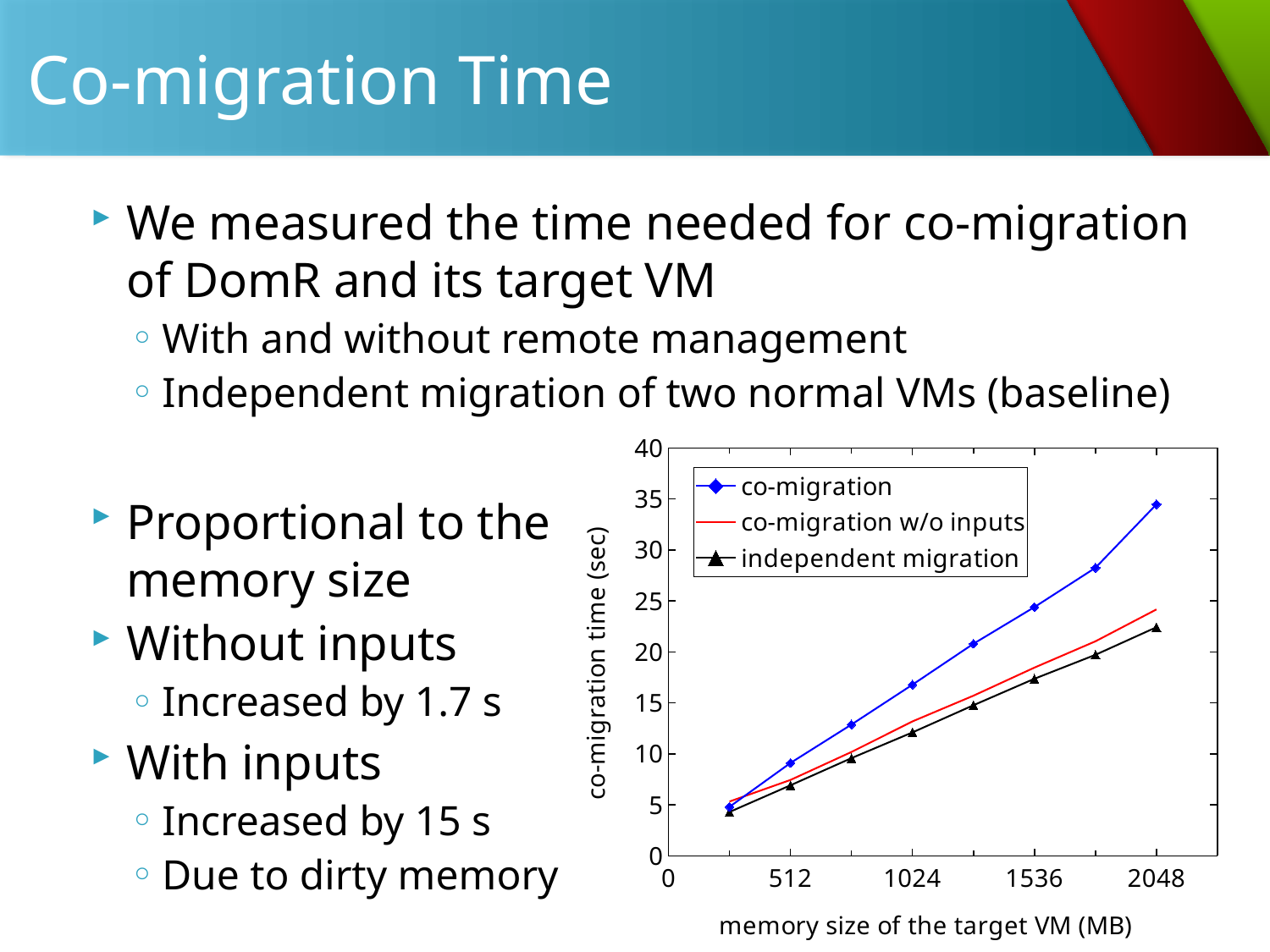
Is the co-migration time at 2048 MB greater or less than 30 sec? greater At 2048 MB, which is larger: the co-migration time or the independent migration time? co-migration What kind of chart is shown on the slide? line chart What is the label of the y axis of the chart? co-migration time (sec) Which series has the lowest co-migration time at a memory size of 2048 MB? independent migration Which series has the highest co-migration time at a memory size of 2048 MB? co-migration What is the label of the x axis of the chart? memory size of the target VM (MB) Is the independent migration time at 2048 MB greater or less than 25 sec? less How many series does the chart legend list? 3 Does the co-migration time rise or fall as the memory size of the target VM increases? rise How many data points are plotted for the co-migration series? 8 Is the co-migration time at 1024 MB greater or less than 15 sec? greater